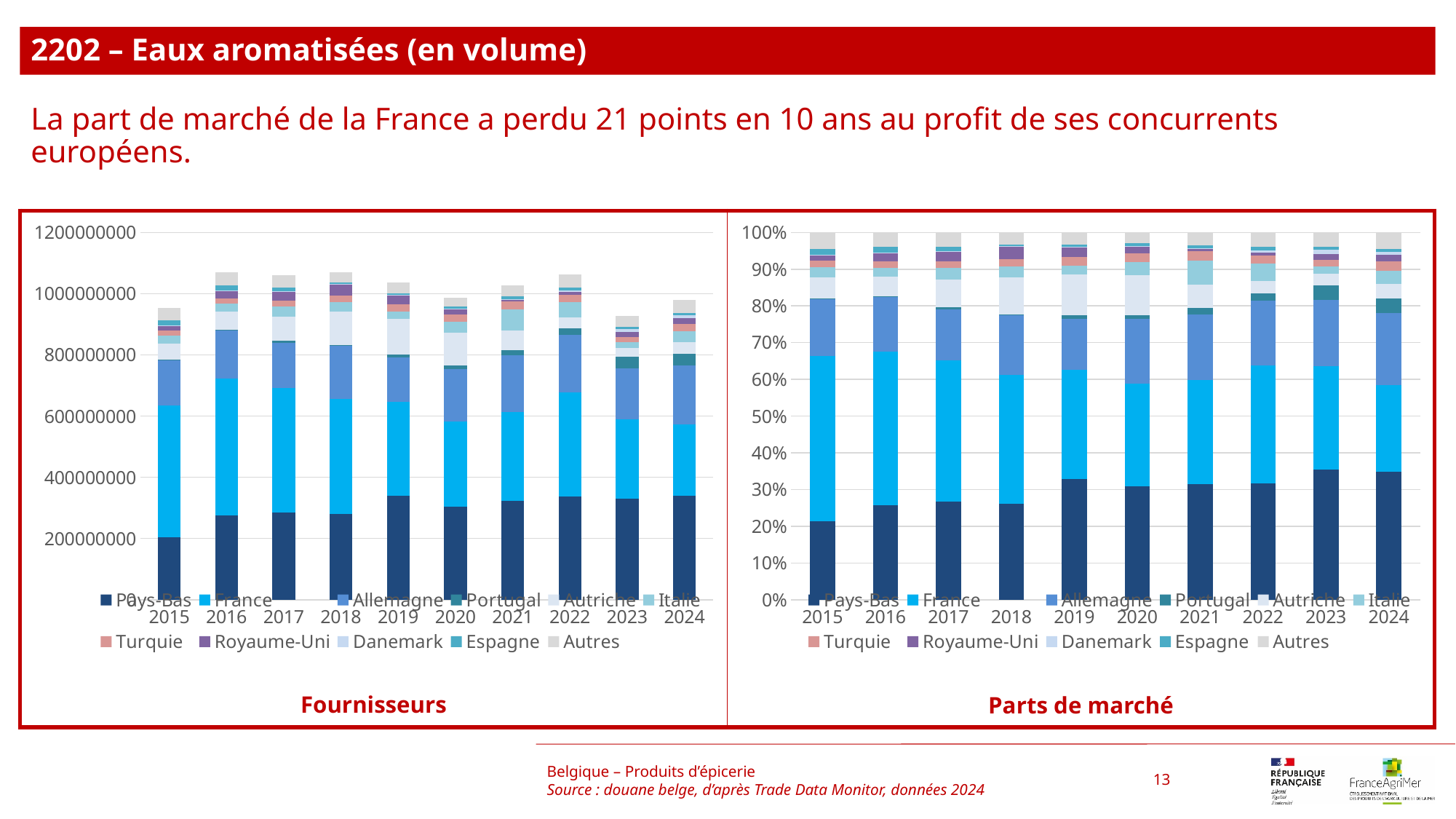
In the 'Fournisseurs' chart, how many years are shown on the x axis? 10 In the 'Fournisseurs' chart, is the value for Pays-Bas in 2015 greater or less than 400000000? less In the 'Parts de marché' chart, which series is shown in dark navy blue at the bottom of each bar? Pays-Bas In the 'Parts de marché' chart, how many series does the legend list? 11 In the 'Parts de marché' chart, does the share of Pays-Bas generally rise or fall from 2015 to 2024? rise In the 'Fournisseurs' chart, is the total of the 2016 bar greater or less than 1000000000? greater In the 'Parts de marché' chart, is the share of Pays-Bas in 2015 greater or less than 30%? less In the 'Fournisseurs' chart, which is larger: the Pays-Bas value in 2015 or in 2024? 2024 What kind of chart is the 'Fournisseurs' chart on the left? Stacked bar chart What kind of chart is the 'Parts de marché' chart on the right? 100% stacked bar chart